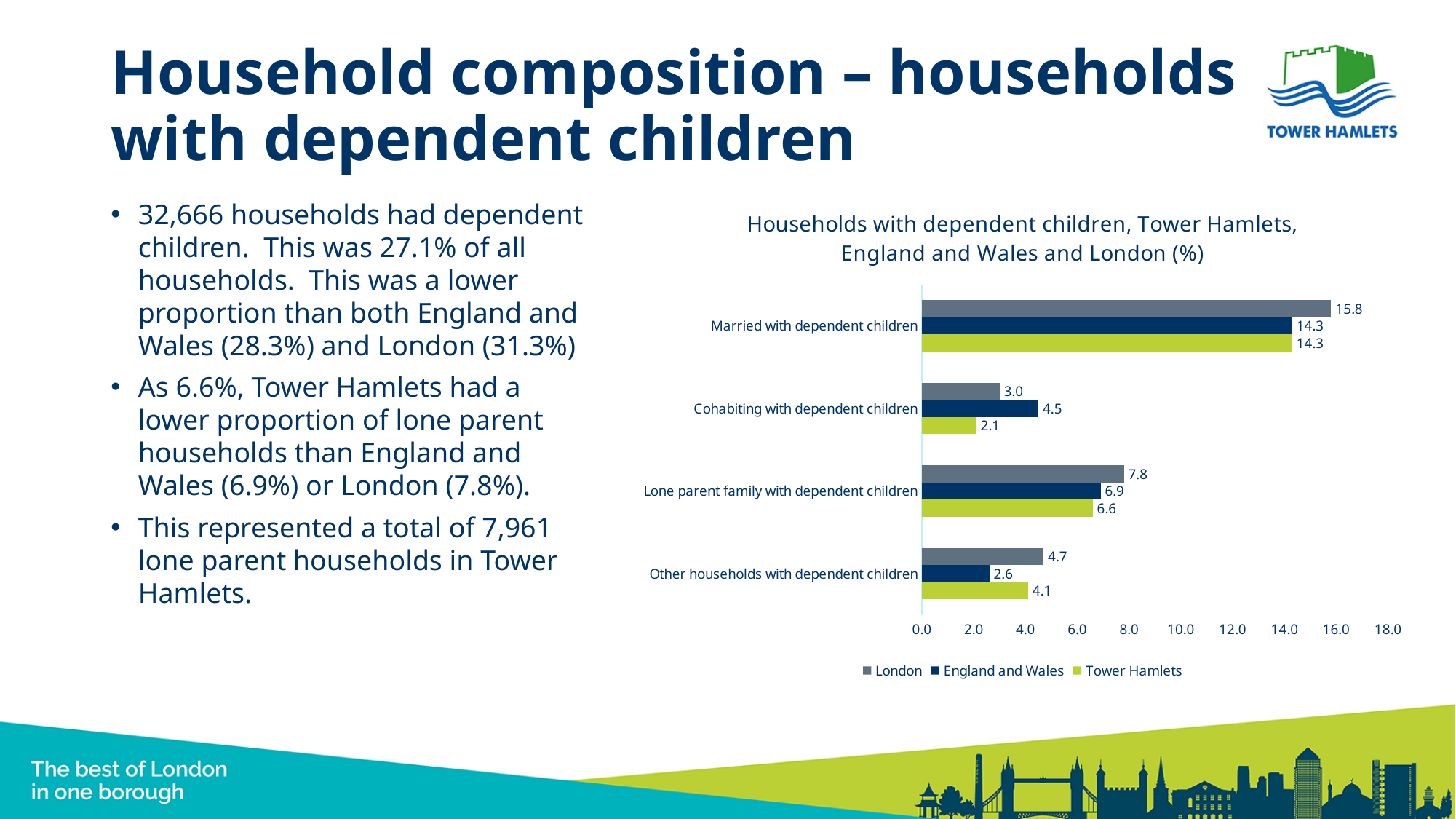
What kind of chart is shown on the slide? Bar chart How many series does the legend list? 3 For Other households with dependent children, which is larger: the England and Wales value or the Tower Hamlets value? Tower Hamlets What is the Tower Hamlets value for Lone parent family with dependent children? 6.6 Which category has the highest London value? Married with dependent children What is the Tower Hamlets value for Other households with dependent children? 4.1 What is the London value for Married with dependent children? 15.8 What is the difference between the London and Tower Hamlets values for Lone parent family with dependent children? 1.2 Which series is shown in green on the chart? Tower Hamlets What is the England and Wales value for Cohabiting with dependent children? 4.5 Which category has the lowest Tower Hamlets value? Cohabiting with dependent children How many categories are shown on the chart? 4